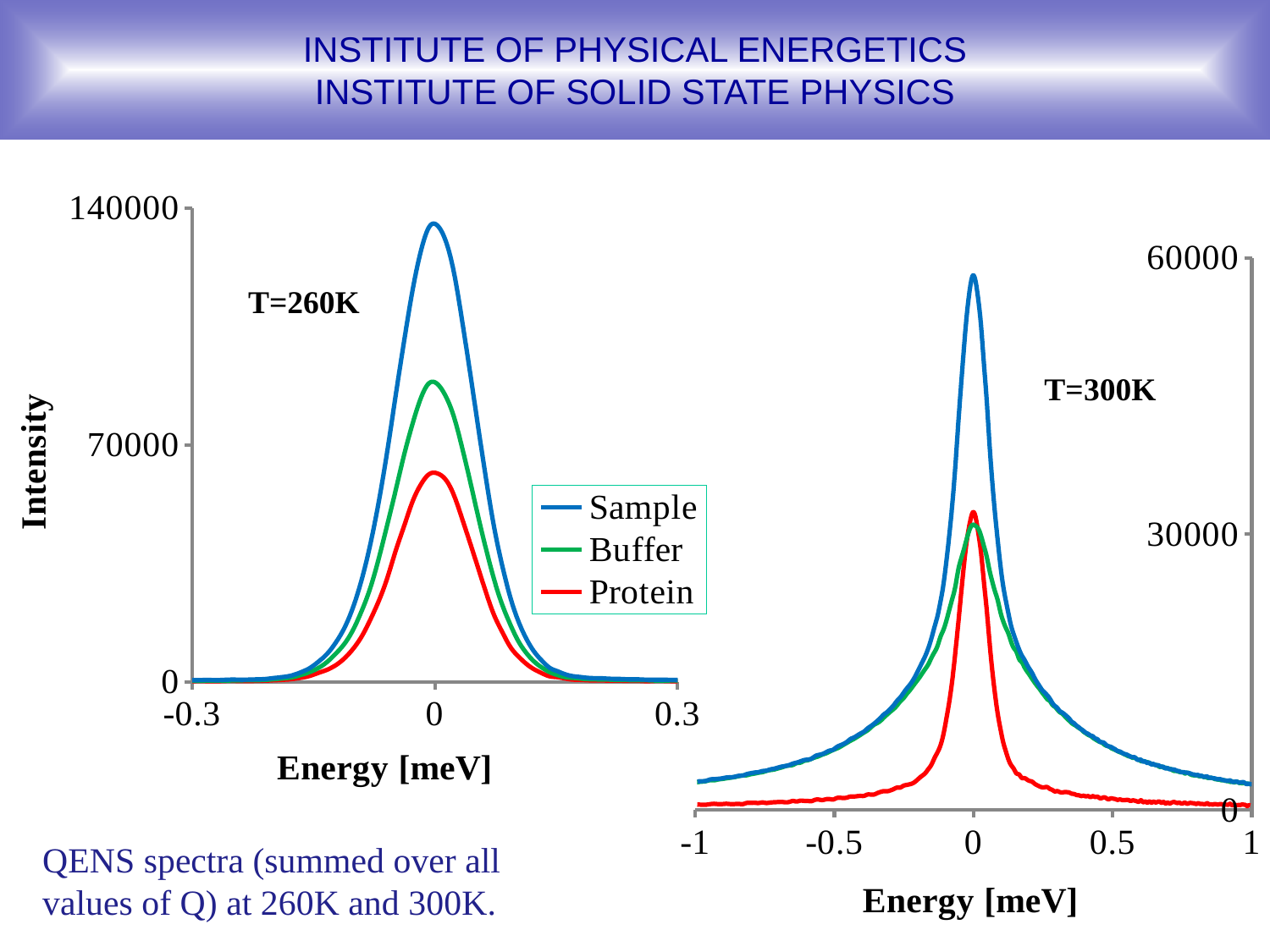
In the T=300K chart, which has a higher peak, the Sample series or the Protein series? Sample What is the x-axis label of the T=260K chart? Energy [meV] In the T=260K chart, is the peak value of the Protein series greater or less than 70000? less How many series does the legend list? 3 What kind of chart is the T=260K chart on the left? line chart What is the highest tick value on the y axis of the T=300K chart? 60000 In the T=260K chart, which has a higher peak, the Sample series or the Buffer series? Sample In the T=260K chart, is the peak value of the Sample series greater or less than 70000? greater In the T=300K chart, is the peak value of the Sample series greater or less than 30000? greater In the T=260K chart, which series has the lowest peak intensity? Protein In the T=300K chart, how many tick labels are shown on the x axis? 5 In the T=260K chart, which series reaches the highest peak intensity? Sample